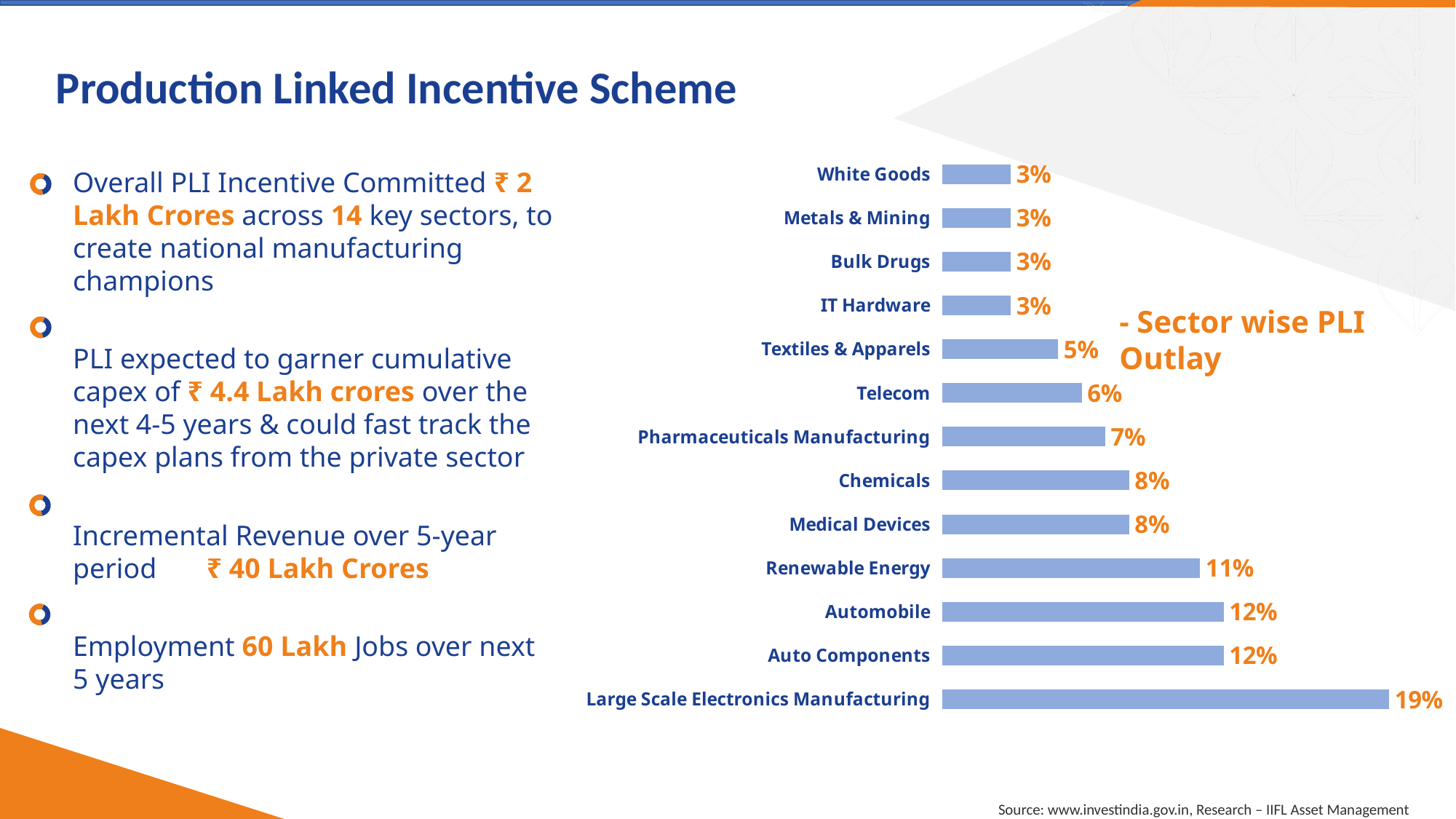
What is the difference in PLI outlay share between Large Scale Electronics Manufacturing and Automobile? 7% What is the title of the chart? Sector wise PLI Outlay What type of chart is used to show the sector wise PLI outlay? Bar chart Which sector has the highest PLI outlay share? Large Scale Electronics Manufacturing What is the difference in PLI outlay share between Renewable Energy and Telecom? 5% What is the PLI outlay share for Large Scale Electronics Manufacturing? 19% Which has a larger PLI outlay share, Pharmaceuticals Manufacturing or Chemicals? Chemicals Which has a larger PLI outlay share, Textiles & Apparels or IT Hardware? Textiles & Apparels What is the PLI outlay share for Textiles & Apparels? 5% How many sectors are shown in the chart? 13 What is the PLI outlay share for Renewable Energy? 11% What is the PLI outlay share for Telecom? 6%